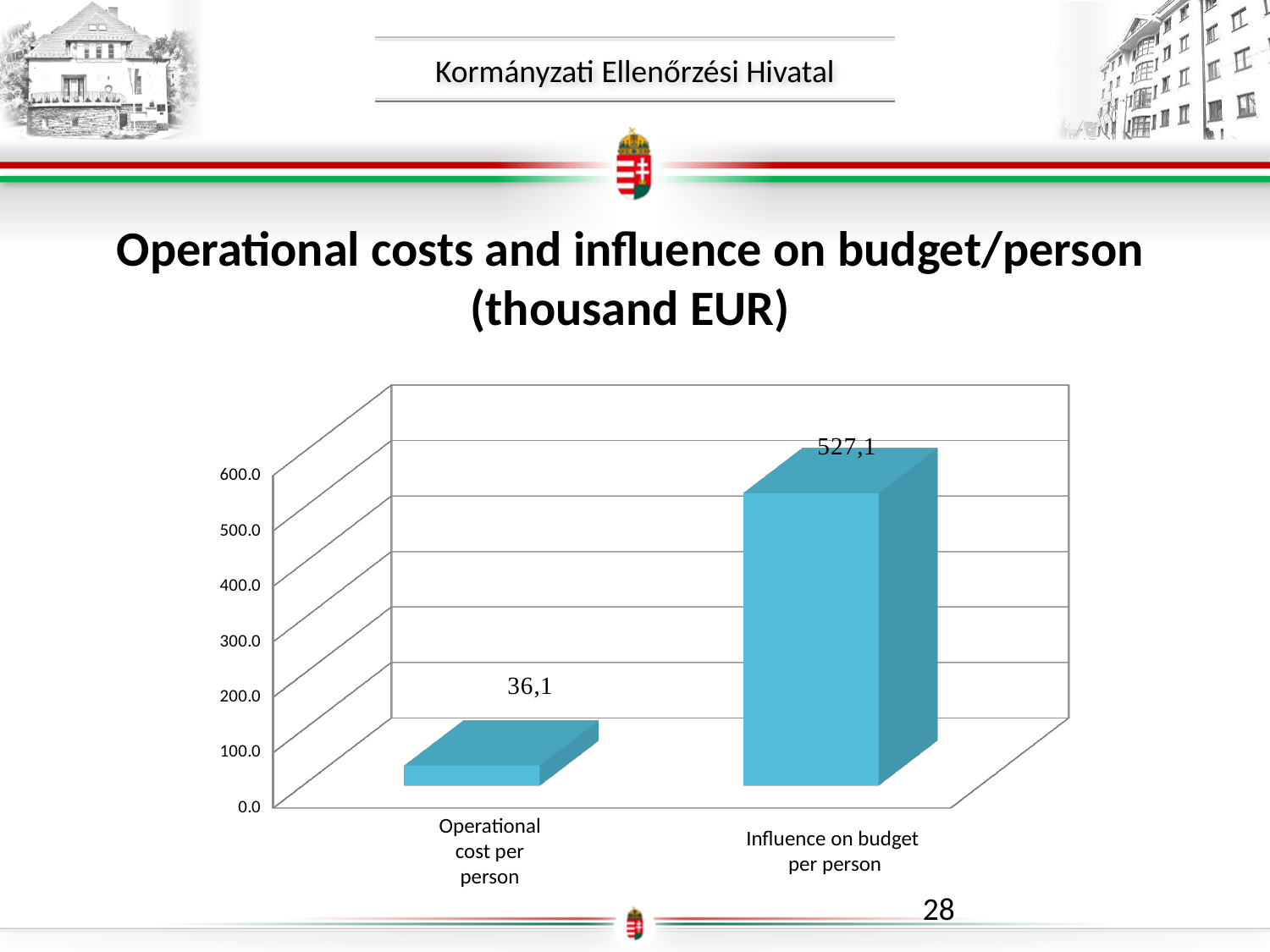
What kind of chart is shown on the slide? bar chart Which is larger: Operational cost per person or Influence on budget per person? Influence on budget per person Is the value for Operational cost per person greater or less than 100? less What is the difference between Influence on budget per person and Operational cost per person? 491,0 What is the value for Operational cost per person? 36,1 How many categories are shown in the chart? 2 What is the title of the chart on the slide? Operational costs and influence on budget/person (thousand EUR) Which category has the highest value? Influence on budget per person What is the value for Influence on budget per person? 527,1 Is the value for Influence on budget per person greater or less than 500? greater What is the highest value shown on the vertical axis? 600.0 Which category has the lowest value? Operational cost per person